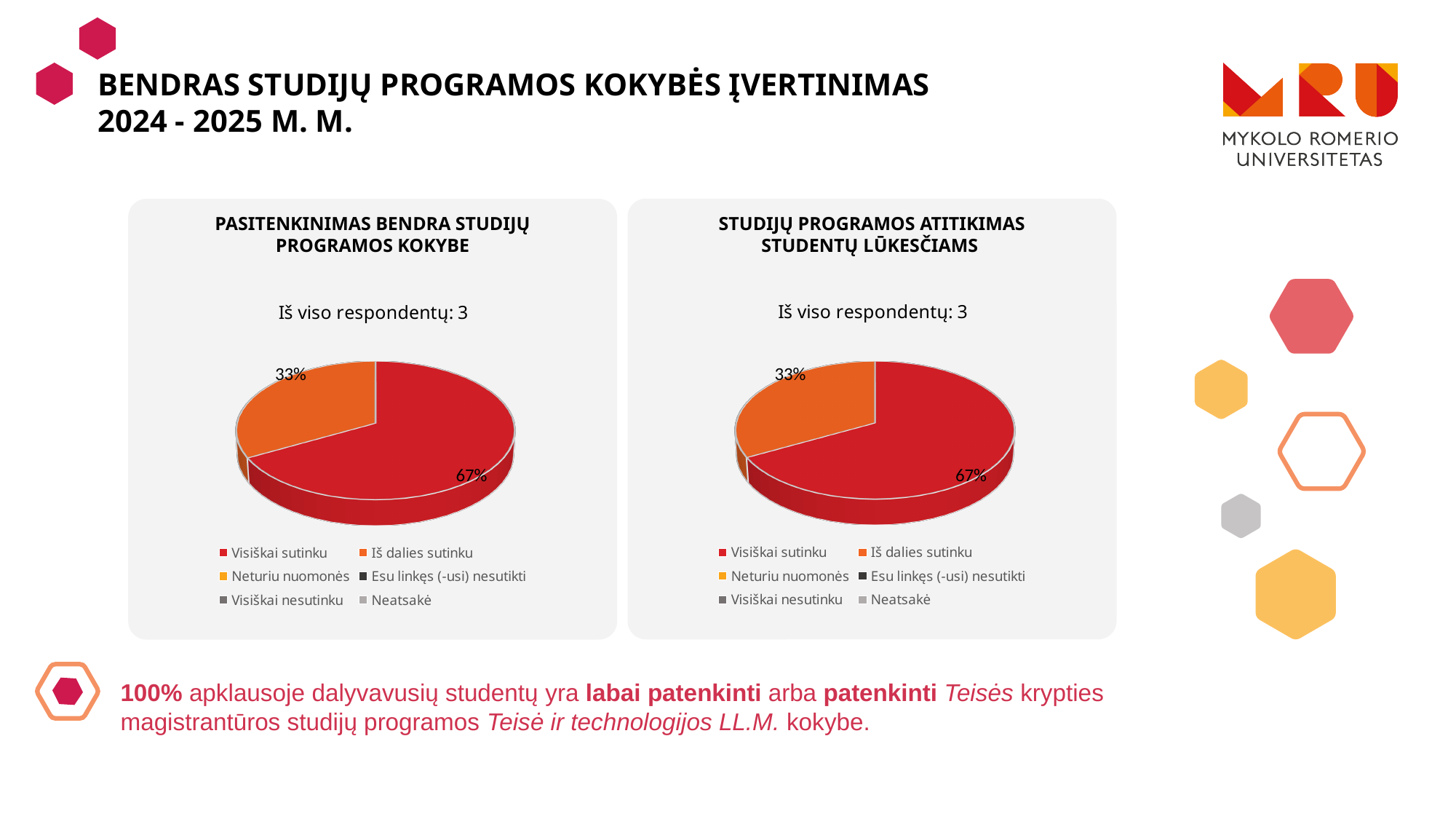
In the right chart, which is larger: the "Visiškai sutinku" slice or the "Iš dalies sutinku" slice? Visiškai sutinku In the chart titled "Pasitenkinimas bendra studijų programos kokybe", what share of respondents answered "Visiškai sutinku"? 67% How many response categories does the legend of the right chart list? 6 In the chart titled "Studijų programos atitikimas studentų lūkesčiams", what share of respondents answered "Iš dalies sutinku"? 33% In the left chart, what colour is the "Iš dalies sutinku" slice? Orange How many respondents in total are reported for the left chart? 3 In the chart titled "Studijų programos atitikimas studentų lūkesčiams", what share of respondents answered "Visiškai sutinku"? 67% In the right chart, which response category has the smallest non-zero slice? Iš dalies sutinku In the chart titled "Pasitenkinimas bendra studijų programos kokybe", what share of respondents answered "Iš dalies sutinku"? 33% In the left chart, which response category has the largest slice? Visiškai sutinku What type of chart is used in the "Pasitenkinimas bendra studijų programos kokybe" panel? Pie chart In the left chart, what is the difference in percentage points between the "Visiškai sutinku" and "Iš dalies sutinku" slices? 34 percentage points